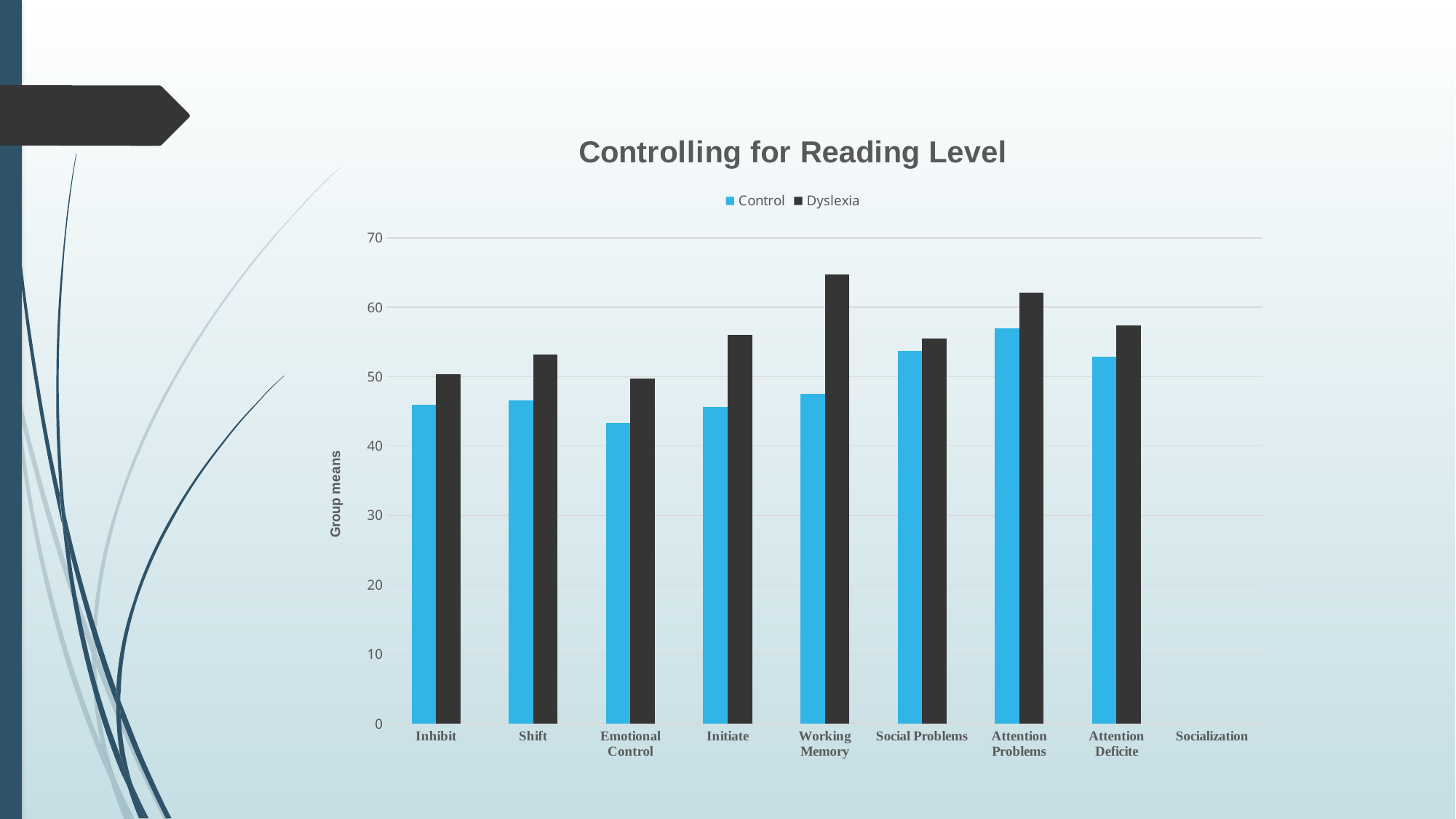
Is the Dyslexia value for Working Memory greater or less than 60? greater What kind of chart is shown on the slide? bar chart What is the label on the vertical axis? Group means For Working Memory, which is larger, the Control value or the Dyslexia value? Dyslexia Is the Control value for Emotional Control greater or less than 50? less For which category is the Control value highest? Attention Problems How many category labels are shown along the x axis? 9 For which category is the Dyslexia value highest? Working Memory For which category is the Control value lowest? Emotional Control Is the Dyslexia value for Initiate greater or less than 50? greater What is the title of the chart? Controlling for Reading Level How many series does the legend list? 2